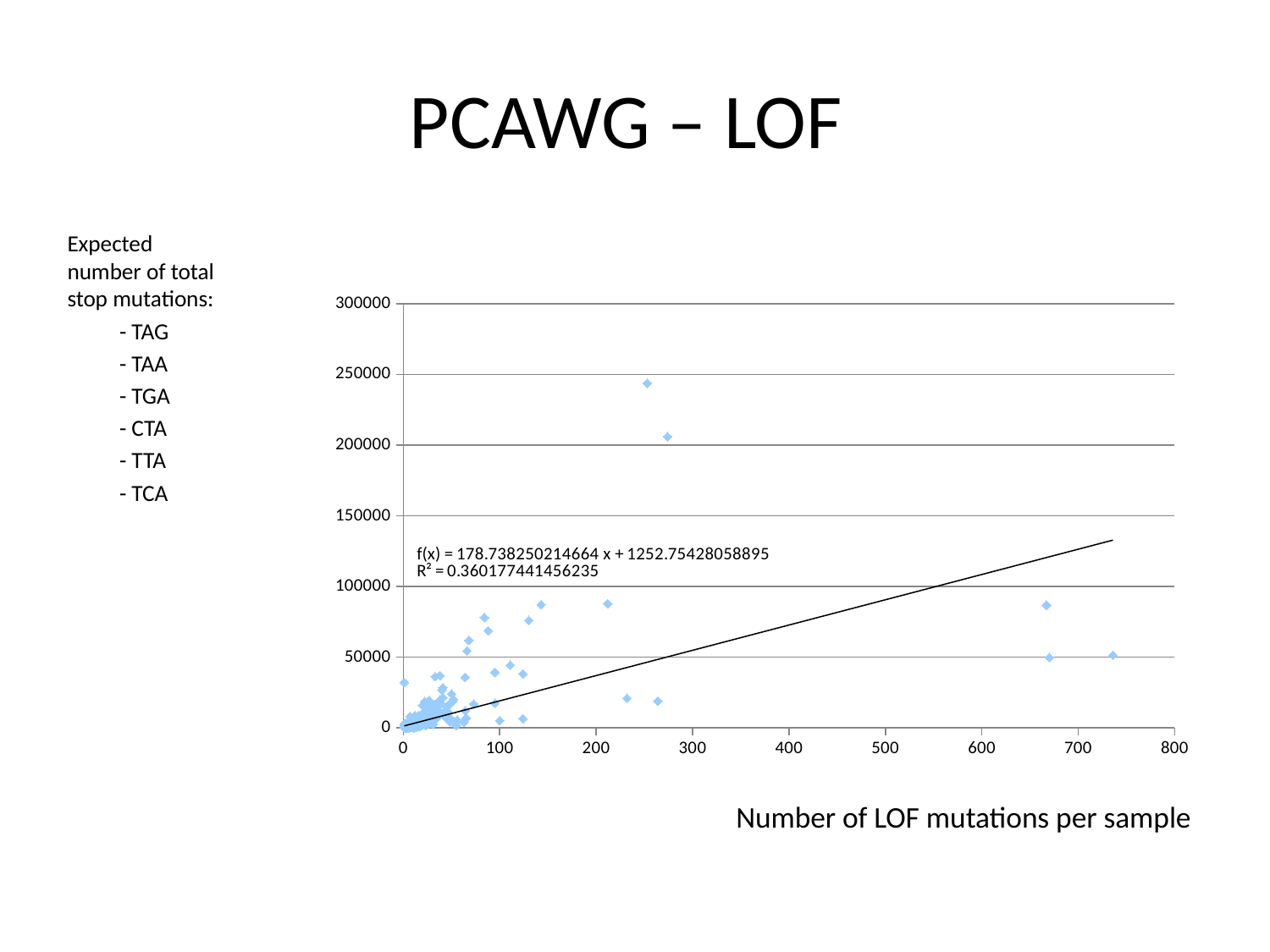
Is the highest plotted point on the chart greater or less than 250000 on the y axis? less What kind of chart is shown on the slide? scatter plot What is the slope of the trendline equation printed on the chart? 178.738250214664 Does the fitted trendline rise or fall as the number of LOF mutations per sample increases? rise What is the label of the x axis of the chart? Number of LOF mutations per sample What R² value is printed on the chart for the trendline? 0.360177441456235 What is the title of the slide containing the chart? PCAWG – LOF Is the x value of the rightmost plotted point greater or less than 700? greater Is the y value of the rightmost plotted point greater or less than 100000? less What is the maximum value shown on the y axis of the chart? 300000